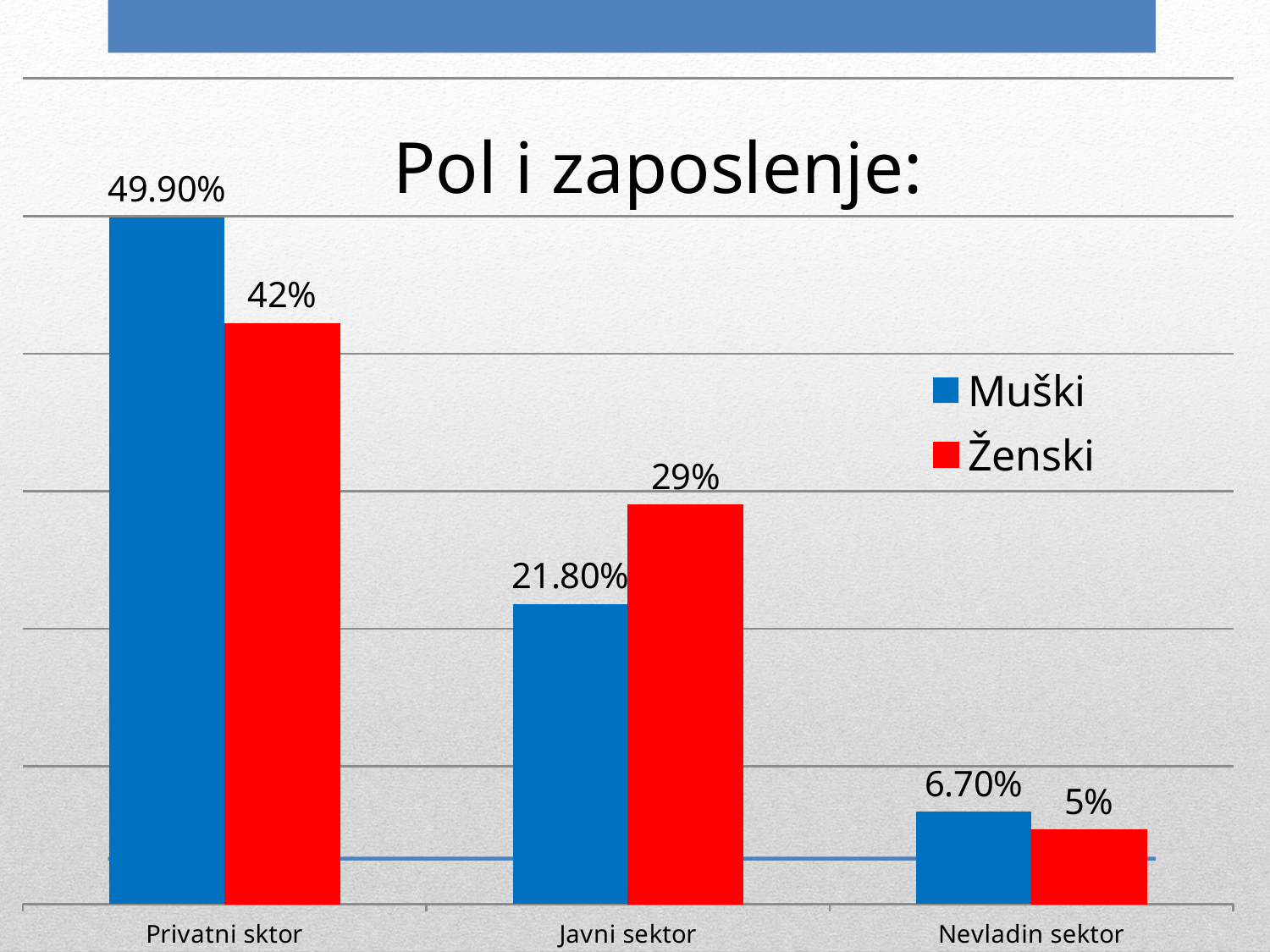
Which category has the lowest value for the Ženski series? Nevladin sektor What is the difference between the Muški and Ženski values in the Privatni sktor category? 7.90 percentage points What is the value for Muški in the Privatni sktor category? 49.90% What is the value for Ženski in the Nevladin sektor category? 5% In the Javni sektor category, which series has the larger value, Muški or Ženski? Ženski Which category has the highest value for the Muški series? Privatni sktor What is the value for Muški in the Nevladin sektor category? 6.70% What is the difference between the Ženski and Muški values in the Javni sektor category? 7.20 percentage points How many categories are shown on the x axis? 3 What is the value for Ženski in the Javni sektor category? 29% How many series does the legend list? 2 What kind of chart is shown on the slide? Bar chart